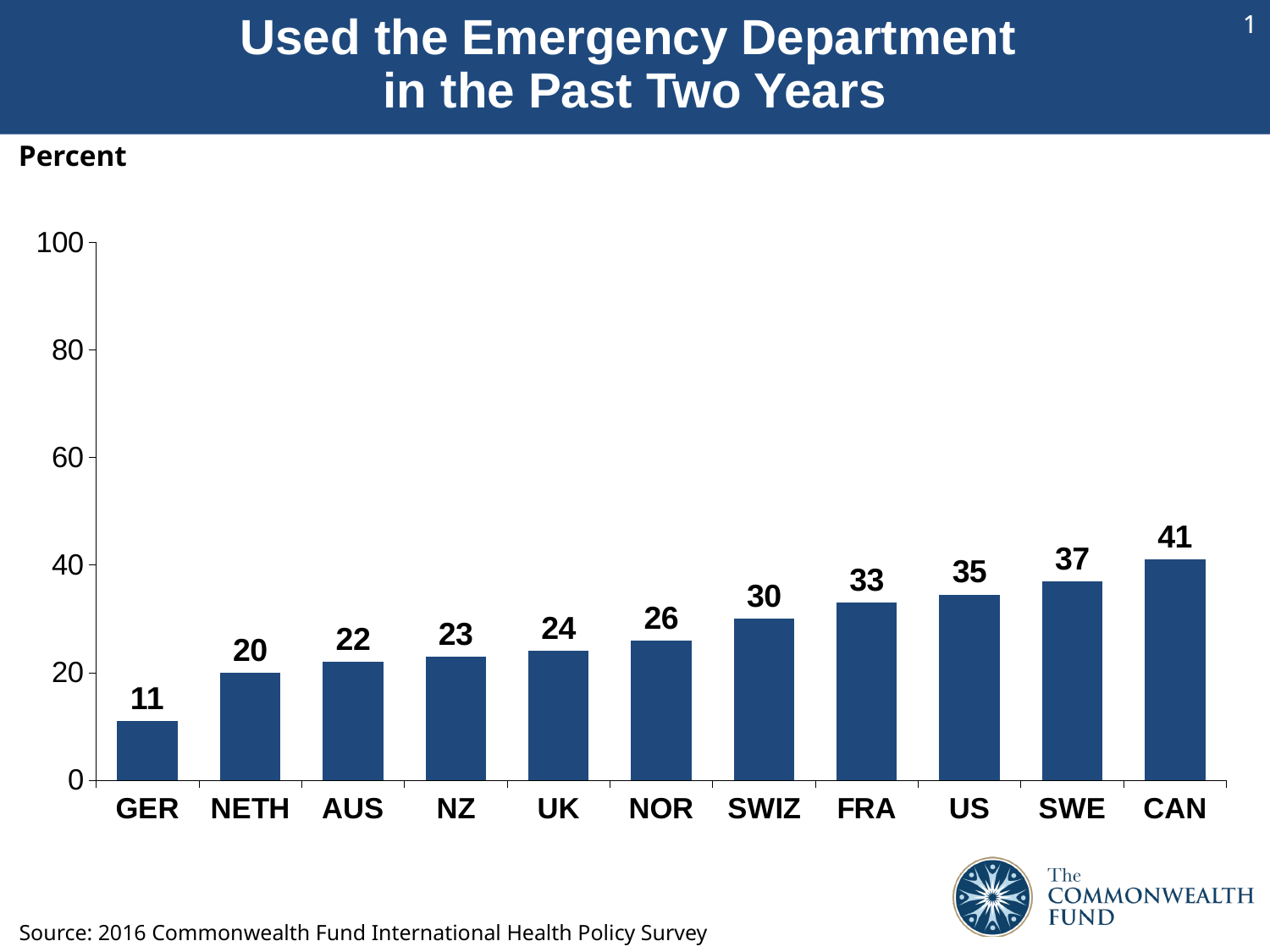
What kind of chart is shown on the slide? bar chart Which country has the highest value? CAN How many countries are shown on the chart? 11 What is the difference between the values for CAN and GER? 30 Which is larger, the value for FRA or the value for NOR? FRA What is the value for GER? 11 What is the value for SWE? 37 What is the value for SWIZ? 30 Is the value for CAN greater or less than 40? greater Do the values rise or fall from left to right across the x axis? rise What is the difference between the values for US and UK? 11 Which country has the lowest value? GER